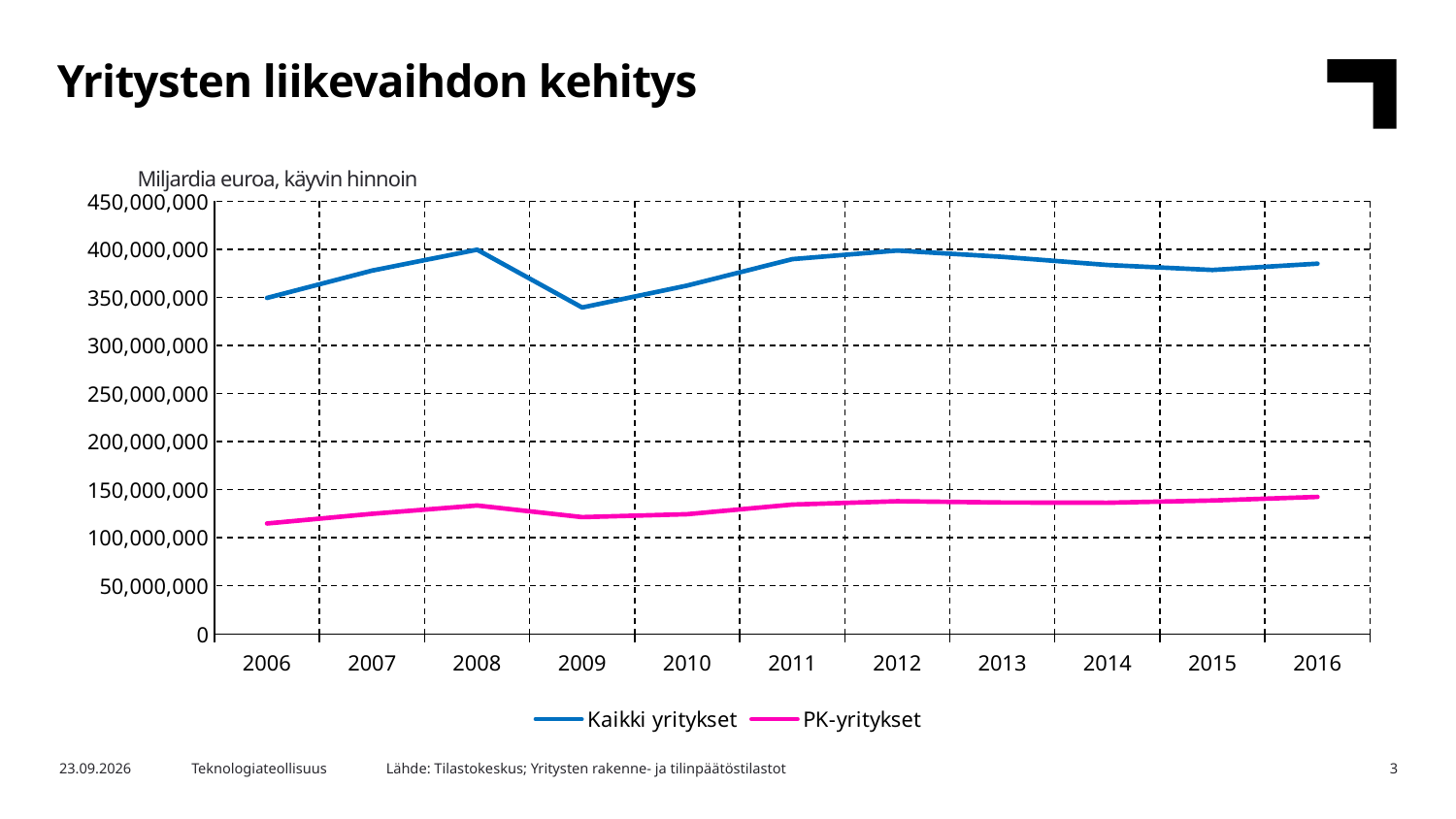
Which is larger for Kaikki yritykset: the value in 2008 or the value in 2009? 2008 How many series does the legend list? 2 In which year is the value for PK-yritykset lowest? 2006 In which year is the value for Kaikki yritykset lowest? 2009 Does the value for PK-yritykset rise or fall from 2012 to 2016? Rise How many years are plotted along the x axis? 11 Is the value for Kaikki yritykset in 2009 greater or less than 350,000,000? less Is the value for PK-yritykset in 2016 greater or less than 150,000,000? less What is the title of the chart on the slide? Yritysten liikevaihdon kehitys Is the value for Kaikki yritykset in 2008 greater or less than 350,000,000? greater What kind of chart is shown on the slide? Line chart In which year is the value for PK-yritykset highest? 2016